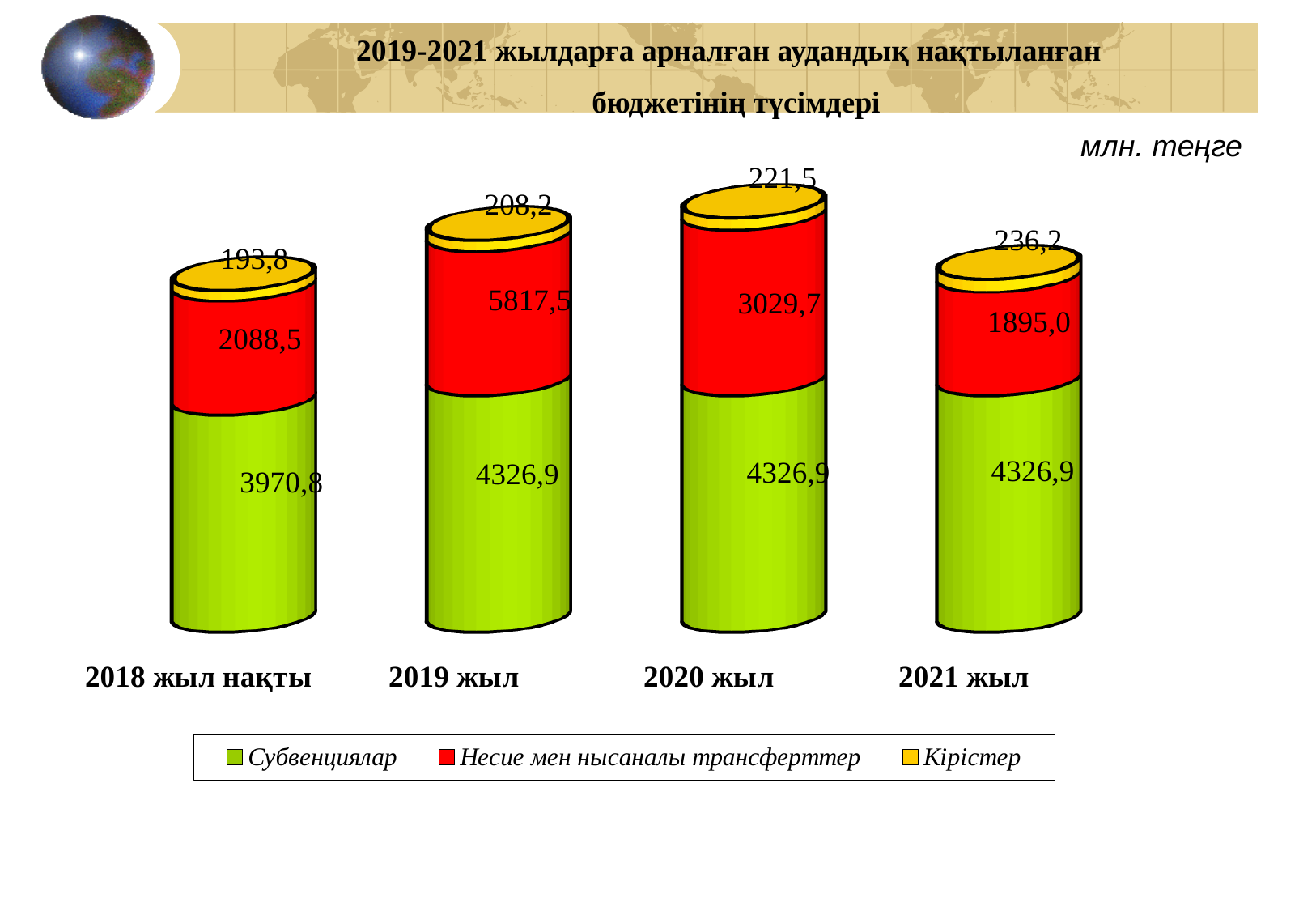
What is the value of Несие мен нысаналы трансферттер for 2020 жыл? 3029,7 What is the value of Кірістер for 2021 жыл? 236,2 What is the difference between the Кірістер values for 2021 жыл and 2018 жыл нақты? 42,4 What kind of chart is shown on the slide? Stacked bar chart Which year has the highest value for Кірістер? 2021 жыл What is the difference between the Несие мен нысаналы трансферттер values for 2020 жыл and 2021 жыл? 1134,7 What is the total of the stacked bar for 2021 жыл? 6458,1 Which year has the lowest value for Субвенциялар? 2018 жыл нақты How many series does the legend list? 3 What is the value of Субвенциялар for 2018 жыл нақты? 3970,8 Which is larger: Несие мен нысаналы трансферттер for 2020 жыл or for 2021 жыл? 2020 жыл How many years (categories) are shown on the chart? 4